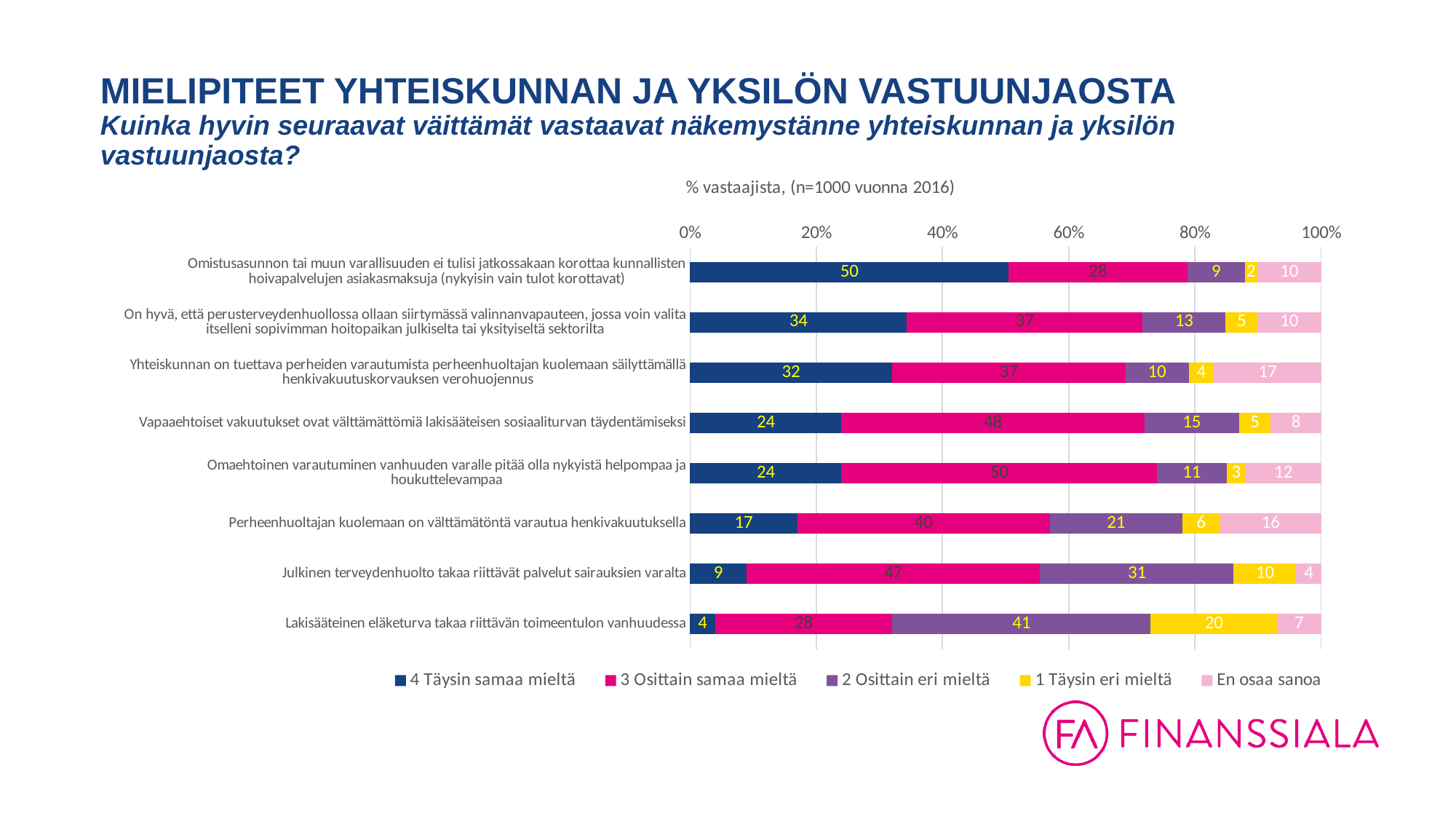
What is the subtitle text shown above the chart describing the respondents? % vastaajista, (n=1000 vuonna 2016) How many statements (categories) are plotted in the chart? 8 What type of chart is shown on the slide? Stacked bar chart What is the value of '3 Osittain samaa mieltä' for the statement 'Omaehtoinen varautuminen vanhuuden varalle pitää olla nykyistä helpompaa ja houkuttelevampaa'? 50 How many series does the legend list? 5 Which statement has the lowest value for '1 Täysin eri mieltä'? Omistusasunnon tai muun varallisuuden ei tulisi jatkossakaan korottaa kunnallisten hoivapalvelujen asiakasmaksuja (nykyisin vain tulot korottavat) Which statement has the highest value for '4 Täysin samaa mieltä'? Omistusasunnon tai muun varallisuuden ei tulisi jatkossakaan korottaa kunnallisten hoivapalvelujen asiakasmaksuja (nykyisin vain tulot korottavat) What is the total of the stacked bar for 'Vapaaehtoiset vakuutukset ovat välttämättömiä lakisääteisen sosiaaliturvan täydentämiseksi'? 100 What is the value of 'En osaa sanoa' for the statement 'Yhteiskunnan on tuettava perheiden varautumista perheenhuoltajan kuolemaan säilyttämällä henkivakuutuskorvauksen verohuojennus'? 17 Which is larger: the '3 Osittain samaa mieltä' value for 'Vapaaehtoiset vakuutukset ovat välttämättömiä lakisääteisen sosiaaliturvan täydentämiseksi' or for 'Perheenhuoltajan kuolemaan on välttämätöntä varautua henkivakuutuksella'? Vapaaehtoiset vakuutukset ovat välttämättömiä lakisääteisen sosiaaliturvan täydentämiseksi What is the difference between the '2 Osittain eri mieltä' values for 'Lakisääteinen eläketurva takaa riittävän toimeentulon vanhuudessa' and 'Julkinen terveydenhuolto takaa riittävät palvelut sairauksien varalta'? 10 What is the value of '4 Täysin samaa mieltä' for the statement 'Lakisääteinen eläketurva takaa riittävän toimeentulon vanhuudessa'? 4